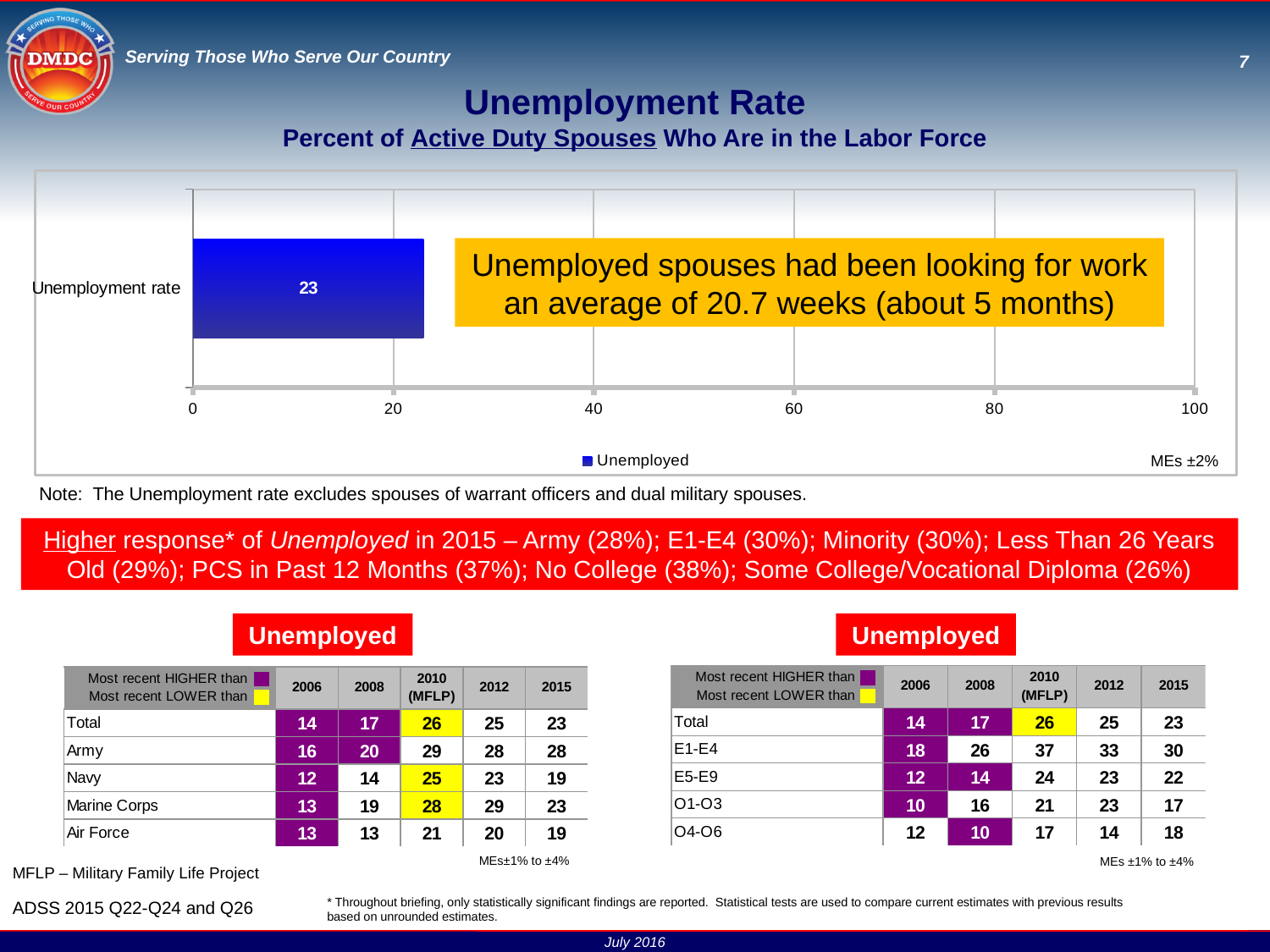
How many series does the chart's legend list? 1 What is the value of the Unemployment rate bar in the chart? 23 Is the value for Unemployment rate greater or less than 20? greater How many bars are plotted in the chart? 1 What is the name of the series shown in the chart's legend? Unemployed What is the highest value shown on the chart's x axis? 100 What kind of chart is shown on the slide? bar chart Is the value for Unemployment rate greater or less than 40? less